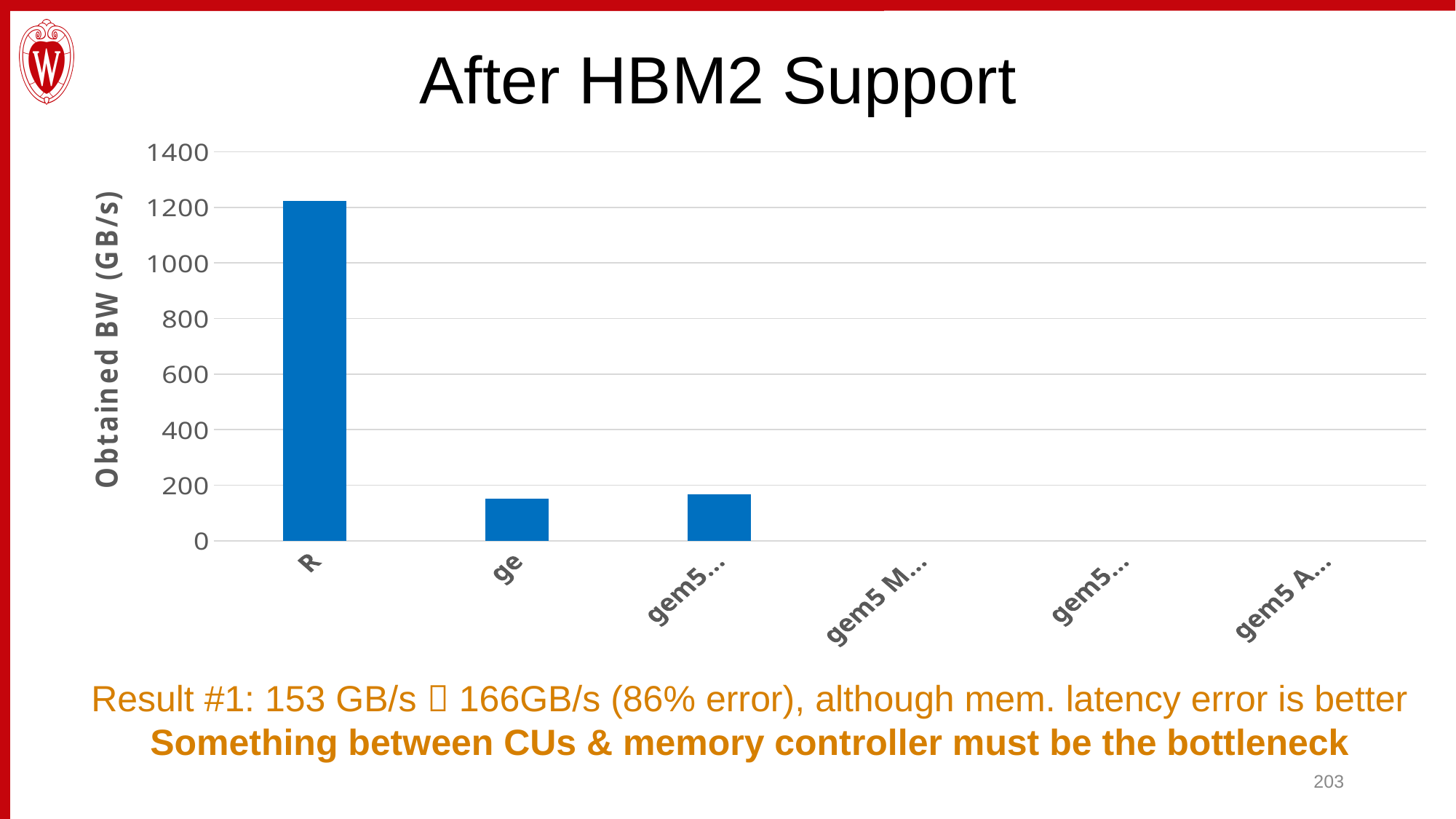
Which is larger, the first bar (labeled R) or the second bar (labeled ge)? the first bar (R) How many bars are plotted in the chart? 3 Is the value of the second bar (labeled ge) greater or less than 200? less Is the value of the third bar (labeled gem5...) greater or less than 400? less What kind of chart is shown on the slide? bar chart Is the value of the first bar (labeled R) greater or less than 1400? less What is the highest tick value shown on the vertical axis of the chart? 1400 Which bar in the chart is the highest? the first bar (labeled R) What is the title of the chart on the slide? After HBM2 Support What is the label of the vertical axis of the chart? Obtained BW (GB/s)